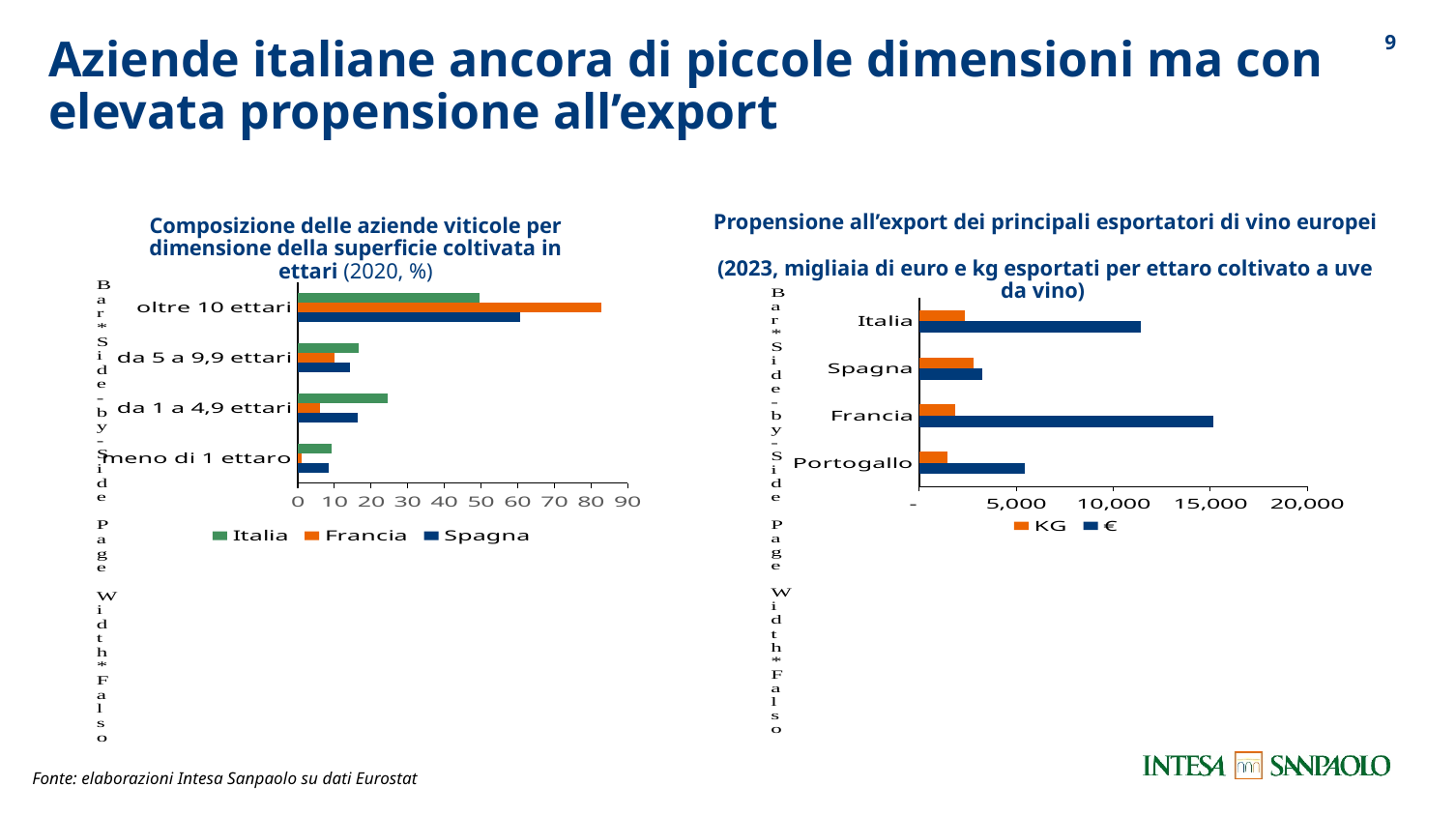
How many countries are shown on the right chart, 'Propensione all'export dei principali esportatori di vino europei'? 4 On the left chart, 'Composizione delle aziende viticole per dimensione della superficie coltivata in ettari', which country has the highest value for 'oltre 10 ettari'? Francia What kind of chart is the left chart, 'Composizione delle aziende viticole per dimensione della superficie coltivata in ettari'? Bar chart What are the two series listed in the legend of the right chart, 'Propensione all'export dei principali esportatori di vino europei'? KG and € On the right chart, 'Propensione all'export dei principali esportatori di vino europei', which country has the lowest € value? Spagna How many series does the legend of the left chart, 'Composizione delle aziende viticole per dimensione della superficie coltivata in ettari', list? 3 On the left chart, 'Composizione delle aziende viticole per dimensione della superficie coltivata in ettari', which country has the lowest value for 'meno di 1 ettaro'? Francia On the right chart, 'Propensione all'export dei principali esportatori di vino europei', is the € value for Italia greater or less than 10,000? greater How many size categories are shown on the left chart, 'Composizione delle aziende viticole per dimensione della superficie coltivata in ettari'? 4 On the left chart, 'Composizione delle aziende viticole per dimensione della superficie coltivata in ettari', is the value for Francia in 'oltre 10 ettari' greater or less than 80? greater On the right chart, 'Propensione all'export dei principali esportatori di vino europei', which country has the highest € value? Francia On the left chart, 'Composizione delle aziende viticole per dimensione della superficie coltivata in ettari', which is larger for 'da 1 a 4,9 ettari': Italia or Francia? Italia